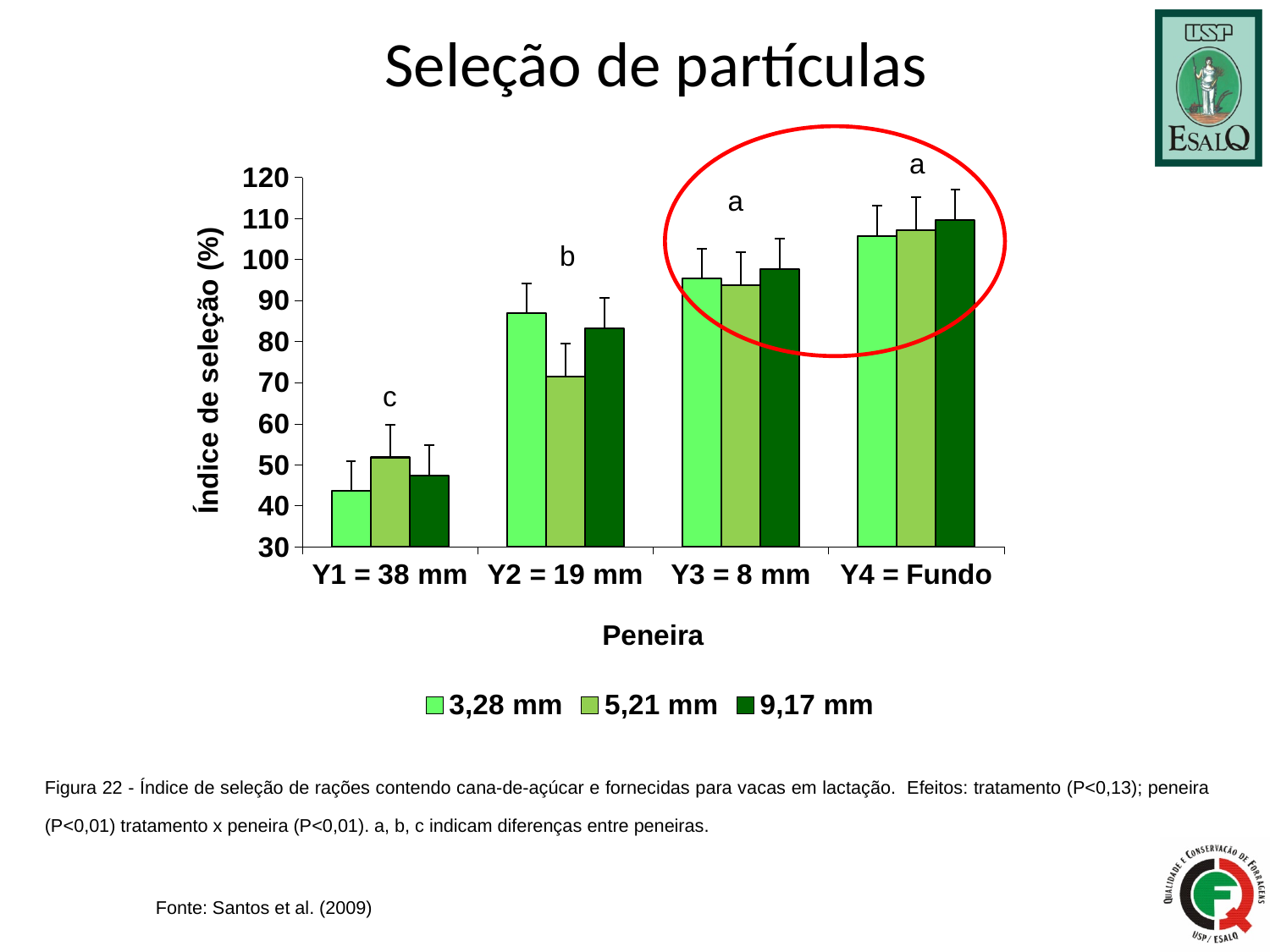
How many categories (peneiras) are shown on the x axis? 4 How many series does the legend list? 3 Is the value for 5,21 mm at Y2 = 19 mm greater or less than 80? less At Y2 = 19 mm, which is larger: the value for 3,28 mm or the value for 5,21 mm? 3,28 mm Is the value for 3,28 mm at Y2 = 19 mm greater or less than 80? greater For the 5,21 mm series, which peneira has the highest value? Y4 = Fundo Do the values for the 9,17 mm series rise or fall from Y1 = 38 mm to Y4 = Fundo? rise For the 9,17 mm series, which peneira has the lowest value? Y1 = 38 mm Is the value for 9,17 mm at Y4 = Fundo greater or less than 100? greater What is the title of the y axis? Índice de seleção (%) What kind of chart is shown on the slide? bar chart